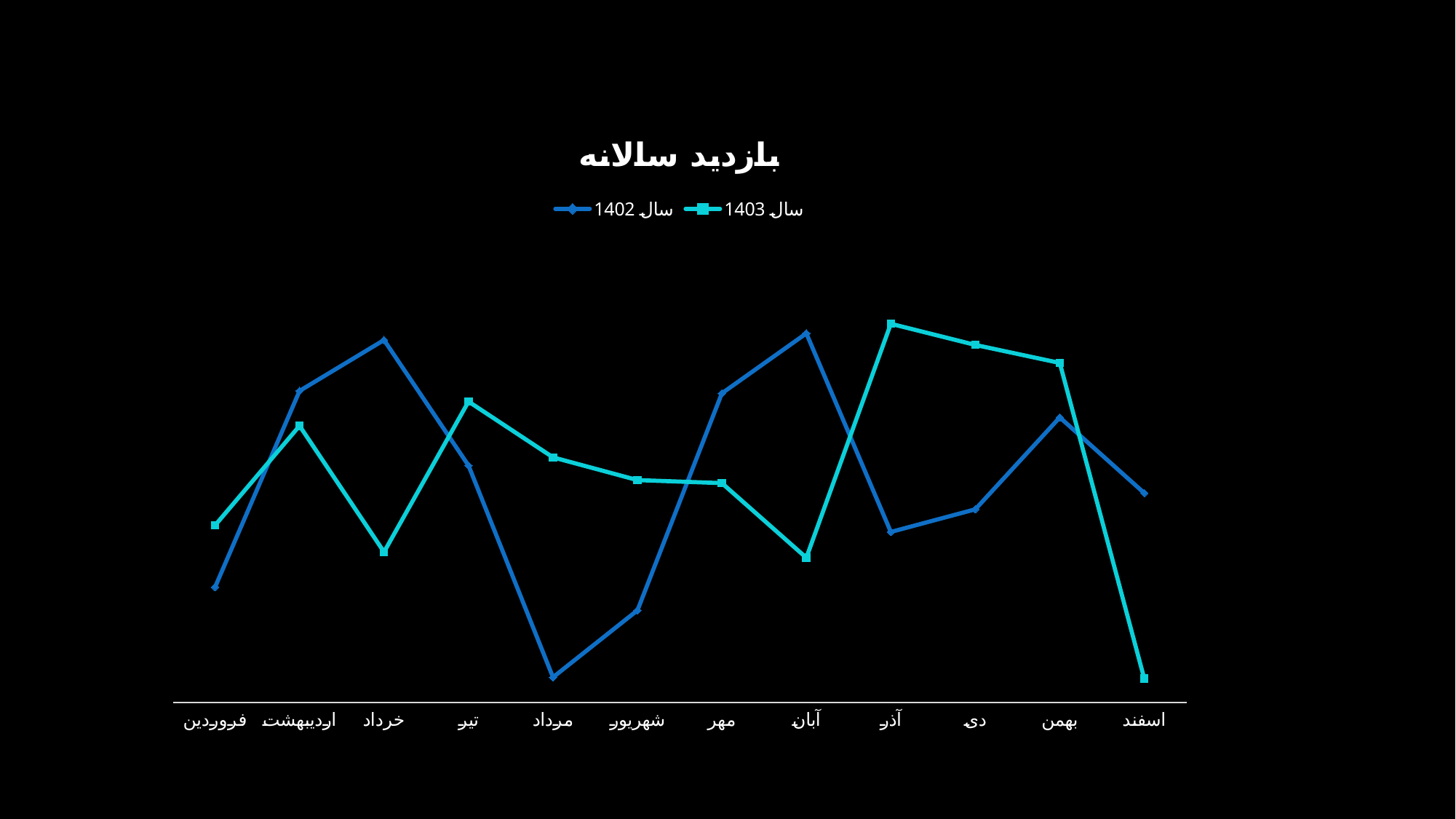
What kind of chart is shown on the slide? Line chart In which month does the سال 1403 series reach its lowest value? اسفند In which month does the سال 1402 series reach its lowest value? مرداد Does the سال 1403 series rise or fall from آذر to اسفند? Fall In which month does the سال 1403 series reach its highest value? آذر In مرداد, which series has the higher value, سال 1402 or سال 1403? سال 1403 What is the title of the chart? بازدید سالانه Which series is drawn with square markers? سال 1403 How many months are shown along the x axis? 12 How many series does the legend list? 2 In خرداد, which series has the higher value, سال 1402 or سال 1403? سال 1402 Does the سال 1402 series rise or fall from فروردین to خرداد? Rise